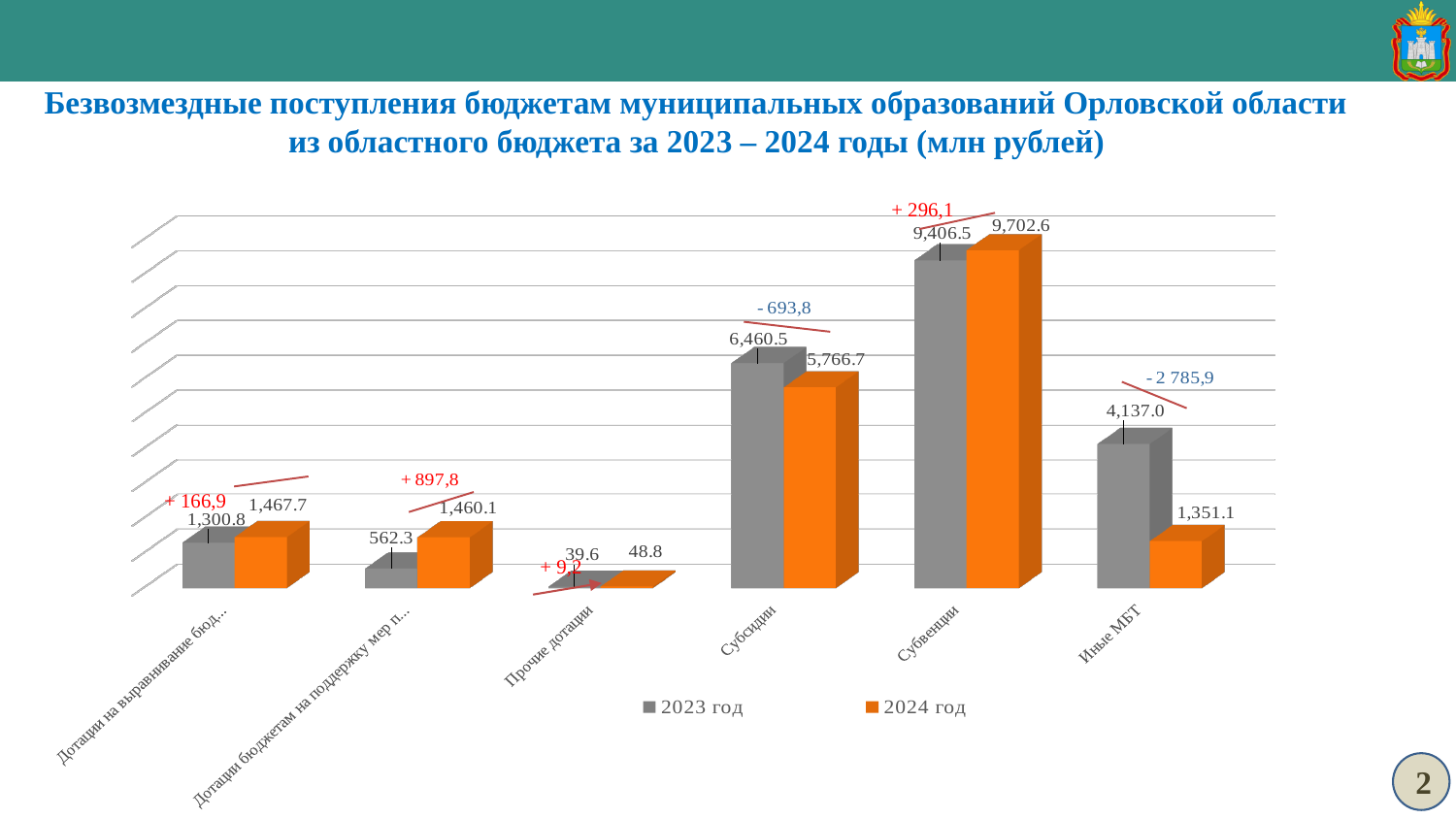
What type of chart is shown on the slide? Bar chart What is the value for Прочие дотации in 2023 год? 39.6 What is the value for Субвенции in 2024 год? 9,702.6 How many series does the legend list? 2 What is the value for Иные МБТ in 2024 год? 1,351.1 What is the difference between the 2023 год and 2024 год values for Иные МБТ? 2,785.9 Which category has the highest value in 2023 год? Субвенции Which colour represents the 2024 год series? Orange How many categories are shown on the x axis? 6 What is the value for Субсидии in 2023 год? 6,460.5 Which category has the lowest value in 2024 год? Прочие дотации Which is larger for Субсидии: the 2023 год value or the 2024 год value? 2023 год